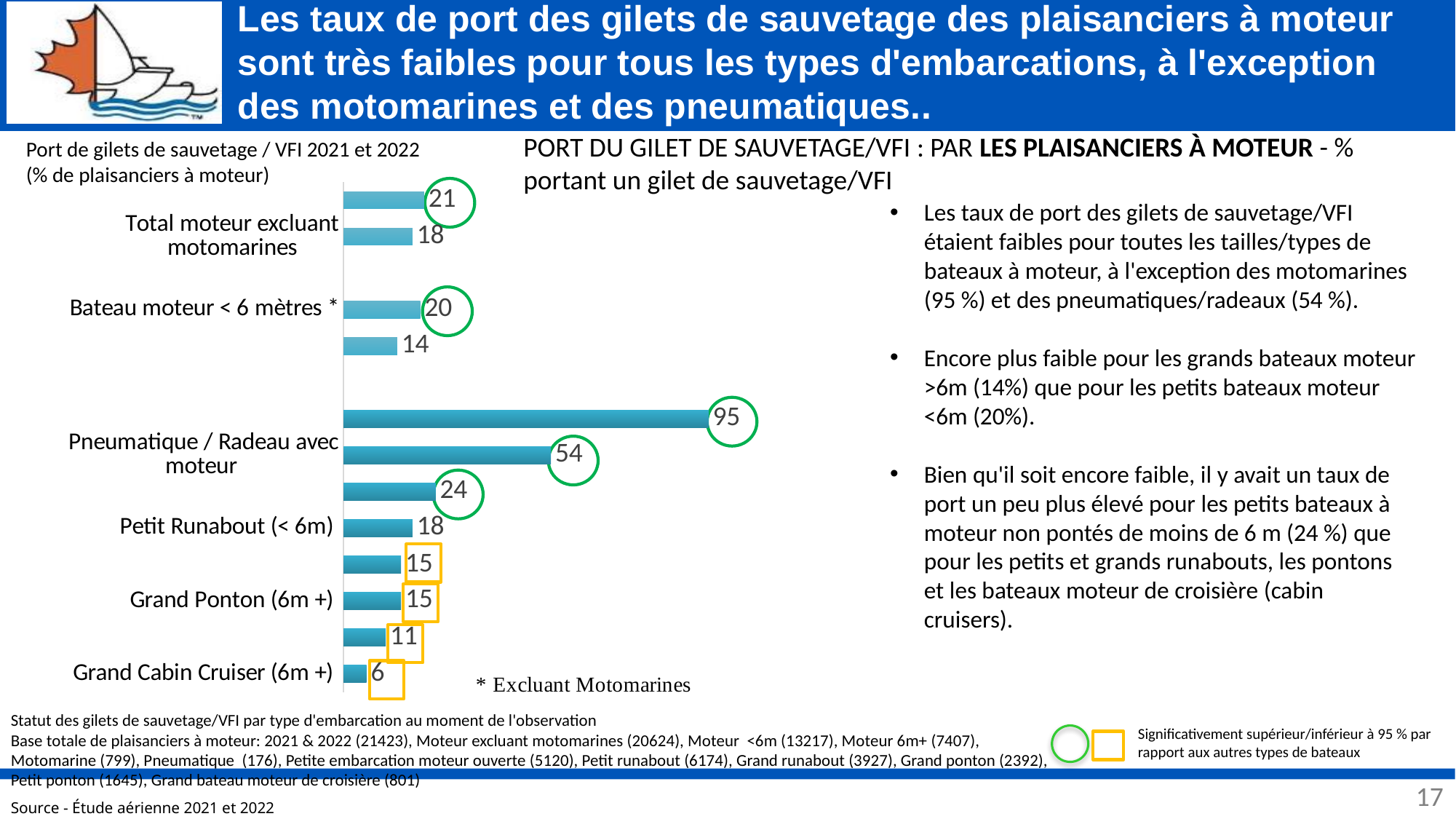
What kind of chart is shown on the slide? bar chart Which labelled category has the lowest value? Grand Cabin Cruiser (6m +) What is the value for Petit Runabout (< 6m)? 18 Which is larger, the value for Grand Ponton (6m +) or Grand Cabin Cruiser (6m +)? Grand Ponton (6m +) What is the value for Bateau moteur < 6 mètres? 20 What is the highest value shown on the chart? 95 What is the value for Grand Ponton (6m +)? 15 What shape marks the values that are significantly lower than other boat types? yellow squares How many bars are plotted on the chart? 12 What is the difference between the values for Pneumatique / Radeau avec moteur and Petit Runabout (< 6m)? 36 What is the value for Pneumatique / Radeau avec moteur? 54 What is the value for Grand Cabin Cruiser (6m +)? 6